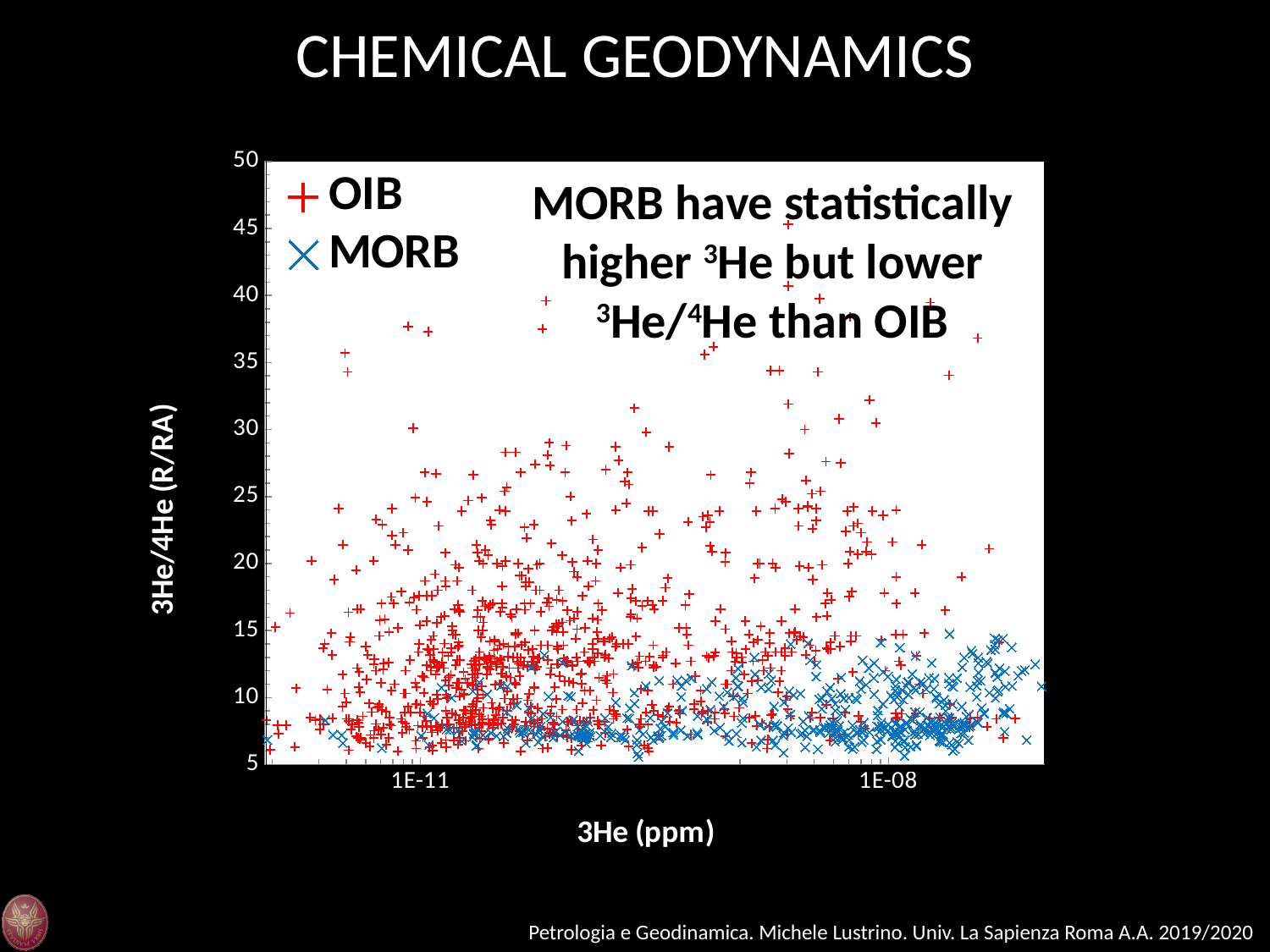
Is the highest MORB value on the y axis greater or less than 20? less Is the highest OIB value on the y axis greater or less than 35? greater What are the two series named in the legend? OIB and MORB What is the label of the y axis? 3He/4He (R/RA) Which series, OIB or MORB, has points extending to higher 3He (ppm) values on the x axis? MORB How many series does the legend list? 2 Which series is plotted with blue x markers? MORB Which series reaches the highest 3He/4He (R/RA) values on the chart? OIB What kind of chart is shown on the slide? scatter plot